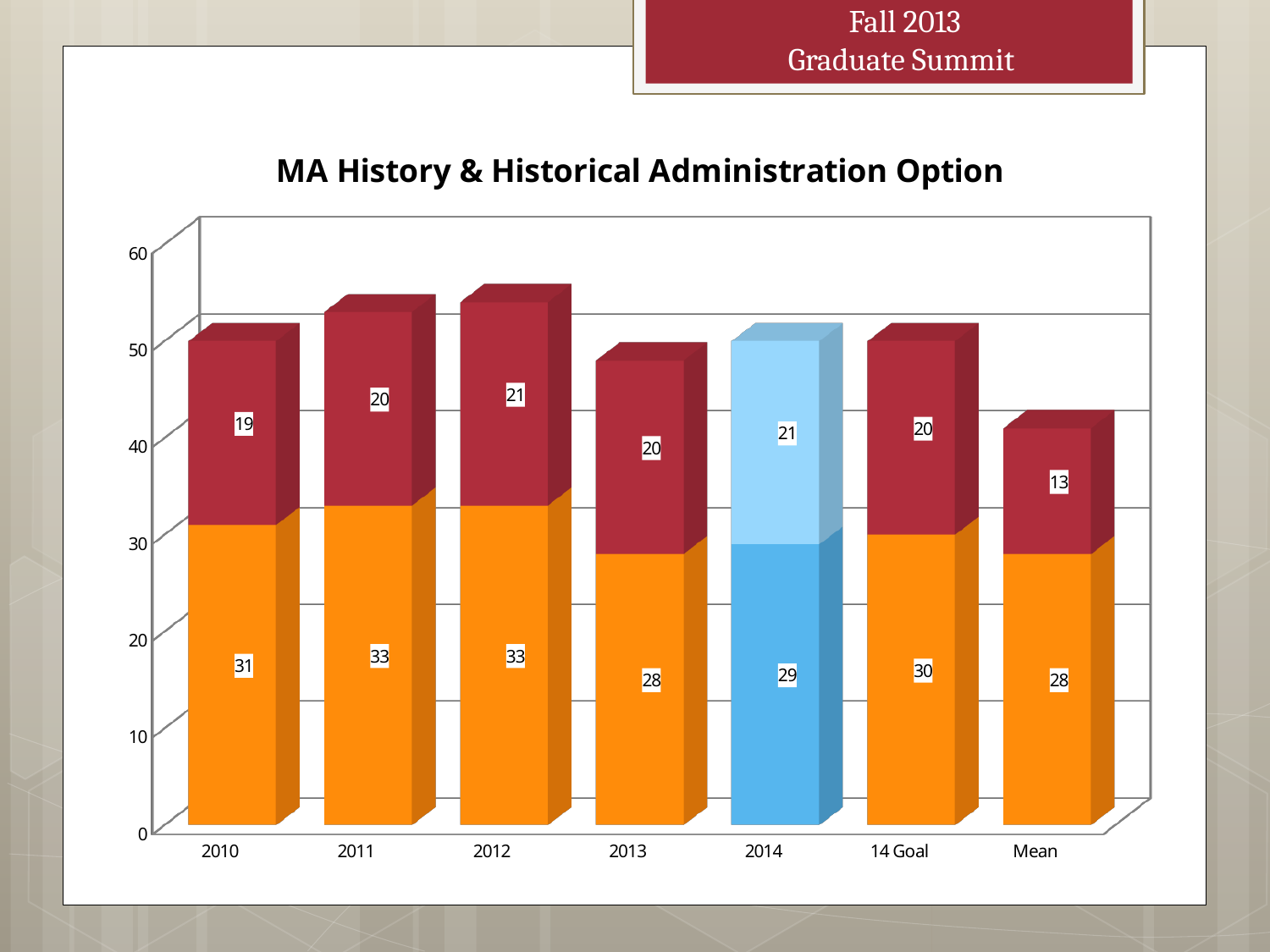
What is the difference between the bottom segment values for 2011 and 2013? 5 Which category has the highest total bar? 2012 What is the title of the chart? MA History & Historical Administration Option Which category has the lowest total bar? Mean How many categories are shown on the x axis? 7 What type of chart is shown on the slide? stacked bar chart What is the value of the bottom segment of the 2014 bar? 29 What is the total of the stacked bar for 2012? 54 What is the total of the stacked bar for 2013? 48 Which bar is drawn in a different colour (blue) from the others? 2014 What is the value of the bottom segment of the 2011 bar? 33 What is the value of the top segment of the Mean bar? 13